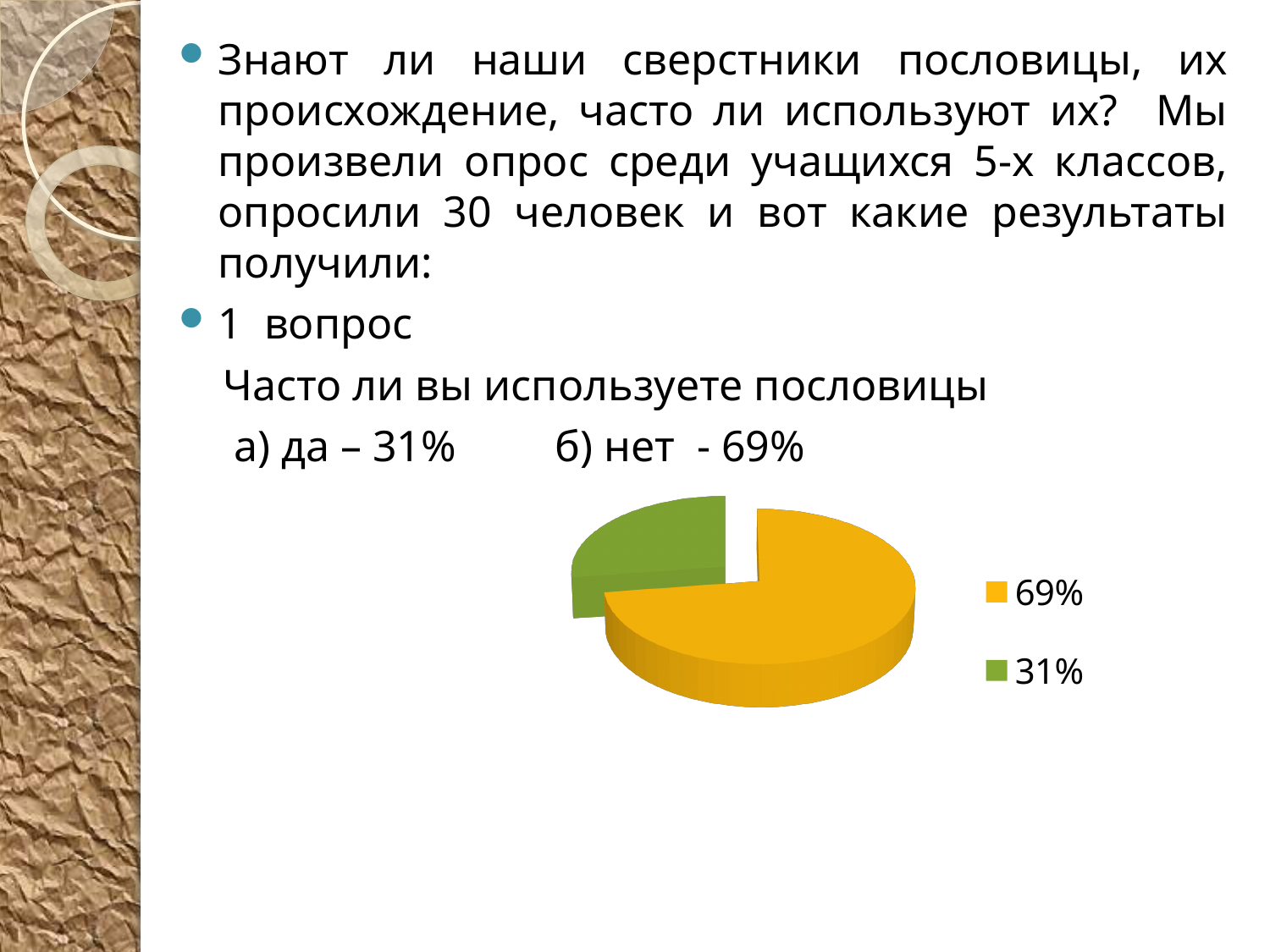
What kind of chart is shown on the slide? pie chart Which slice of the pie chart is the largest? 69% How many slices does the pie chart have? 2 According to the slide text, what percentage of pupils answered 'да' (yes) to whether they often use proverbs? 31% Which slice of the pie chart is the smallest? 31% What colour is the slice labelled 31% in the legend? green What share of the pie does the yellow slice represent? 69% What colour is the slice labelled 69% in the legend? yellow How many entries does the legend of the pie chart list? 2 What is the difference in percentage points between the two slices of the pie chart? 38 Which is larger, the yellow slice or the green slice? the yellow slice What share of the pie does the green slice represent? 31%